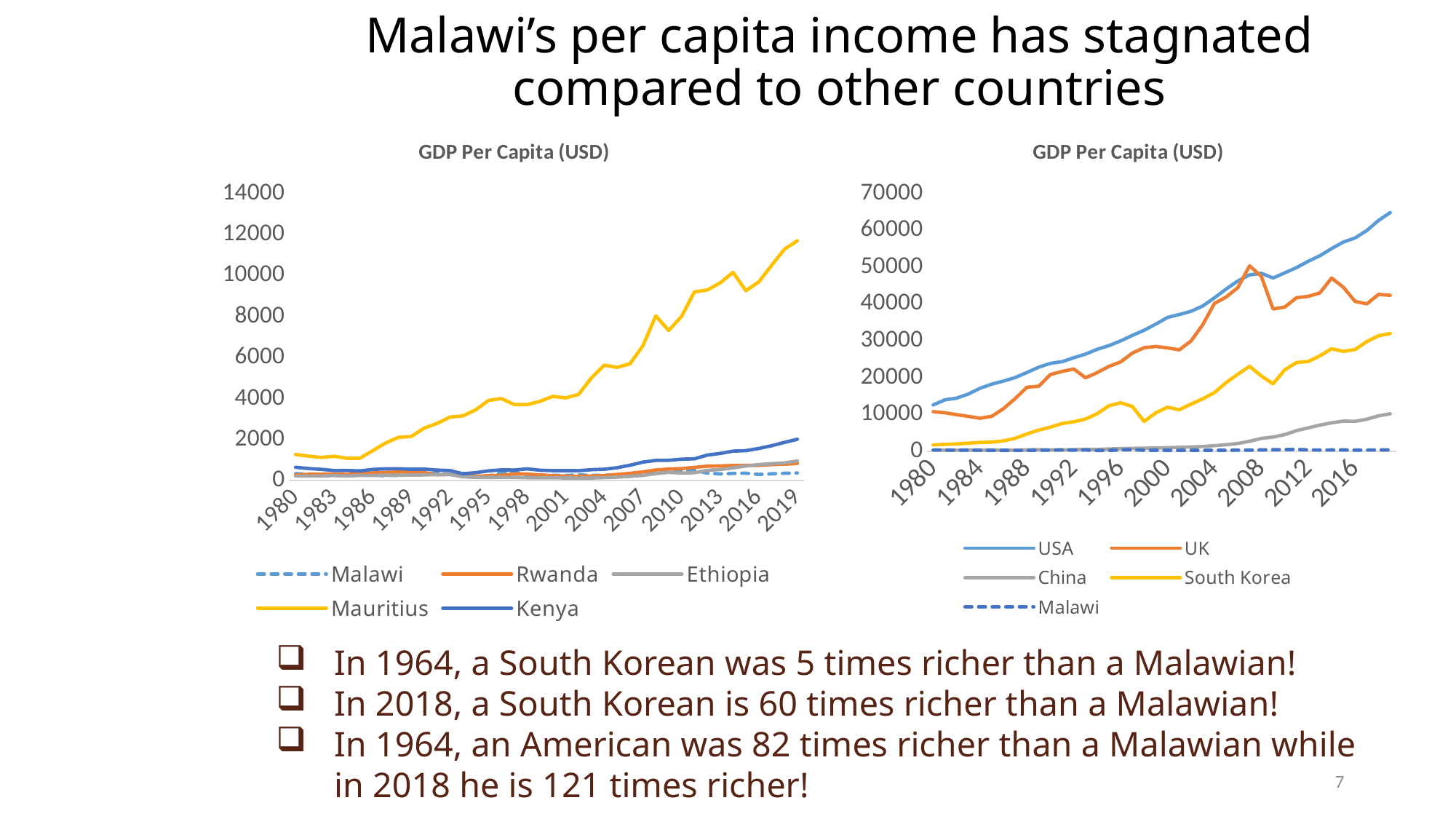
In the left chart, is the value for Mauritius in 2019 greater or less than 10000? greater How many series does the legend of the right chart list? 5 What kind of chart is the left chart? line chart In the left chart, which country has the lowest GDP per capita in 2019? Malawi How many series does the legend of the left chart list? 5 In the right chart, which country has the highest GDP per capita at the end of the series? USA In the right chart, which is larger at the end of the series, the value for USA or the value for UK? USA In the right chart, is the value for China at the end of the series greater or less than 20000? less In the left chart, which country has the highest GDP per capita in 2019? Mauritius Which country appears in the legends of both charts? Malawi In the left chart, does the GDP per capita of Mauritius rise or fall from 1980 to 2019? rise In the right chart, is the value for USA at the end of the series greater or less than 60000? greater